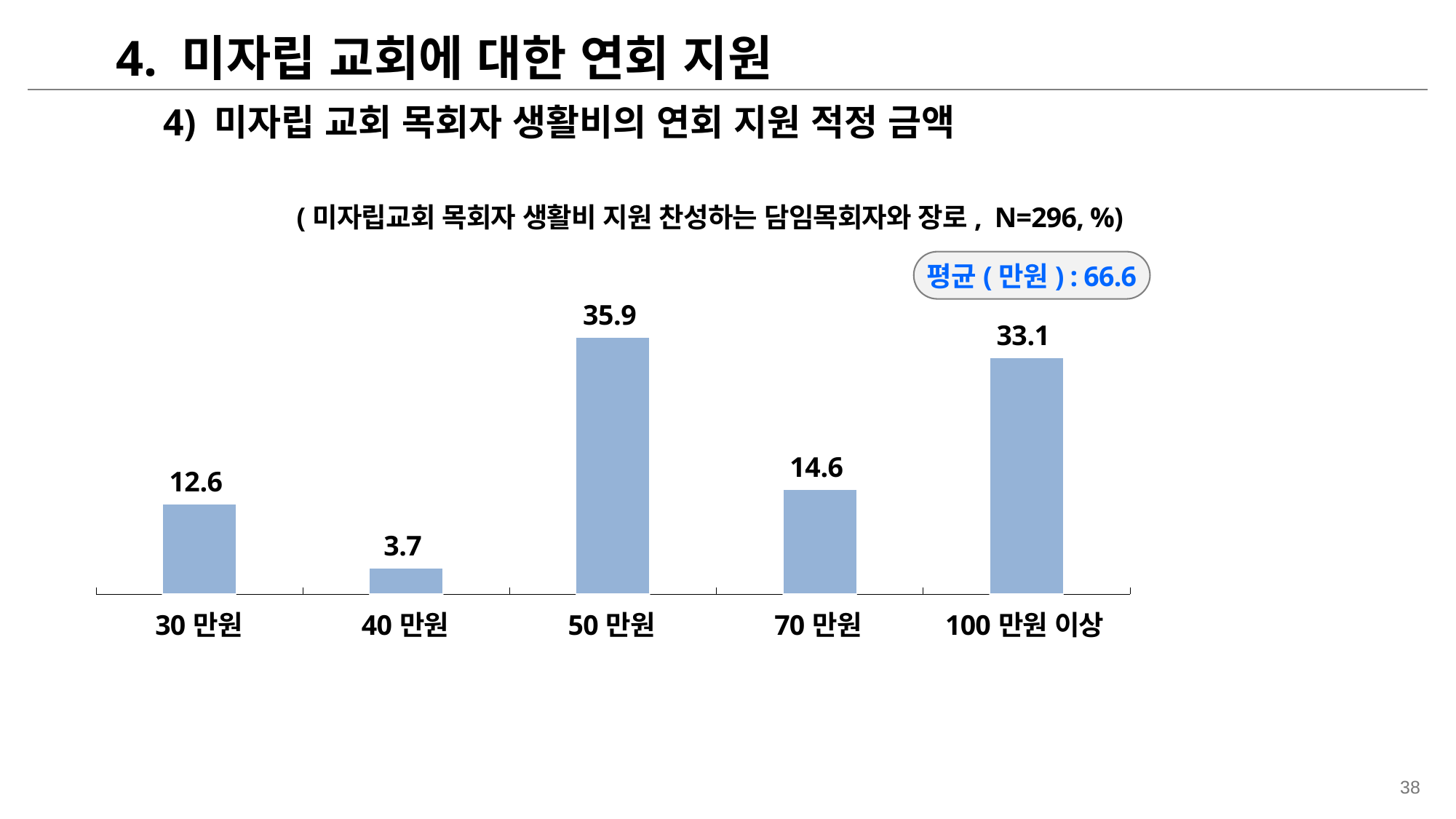
Which category has the lowest value? 40 만원 What kind of chart is shown on the slide? Bar chart What is the value for 70 만원? 14.6 What is the value for 100 만원 이상? 33.1 How many categories are shown on the x axis? 5 Which category has the highest value? 50 만원 What is the value for 50 만원? 35.9 What is the difference between the values for 50 만원 and 100 만원 이상? 2.8 What average value (평균, 만원) is shown in the callout on the chart? 66.6 What is the value for 40 만원? 3.7 Which is larger, the value for 30 만원 or the value for 70 만원? 70 만원 What is the value for 30 만원? 12.6